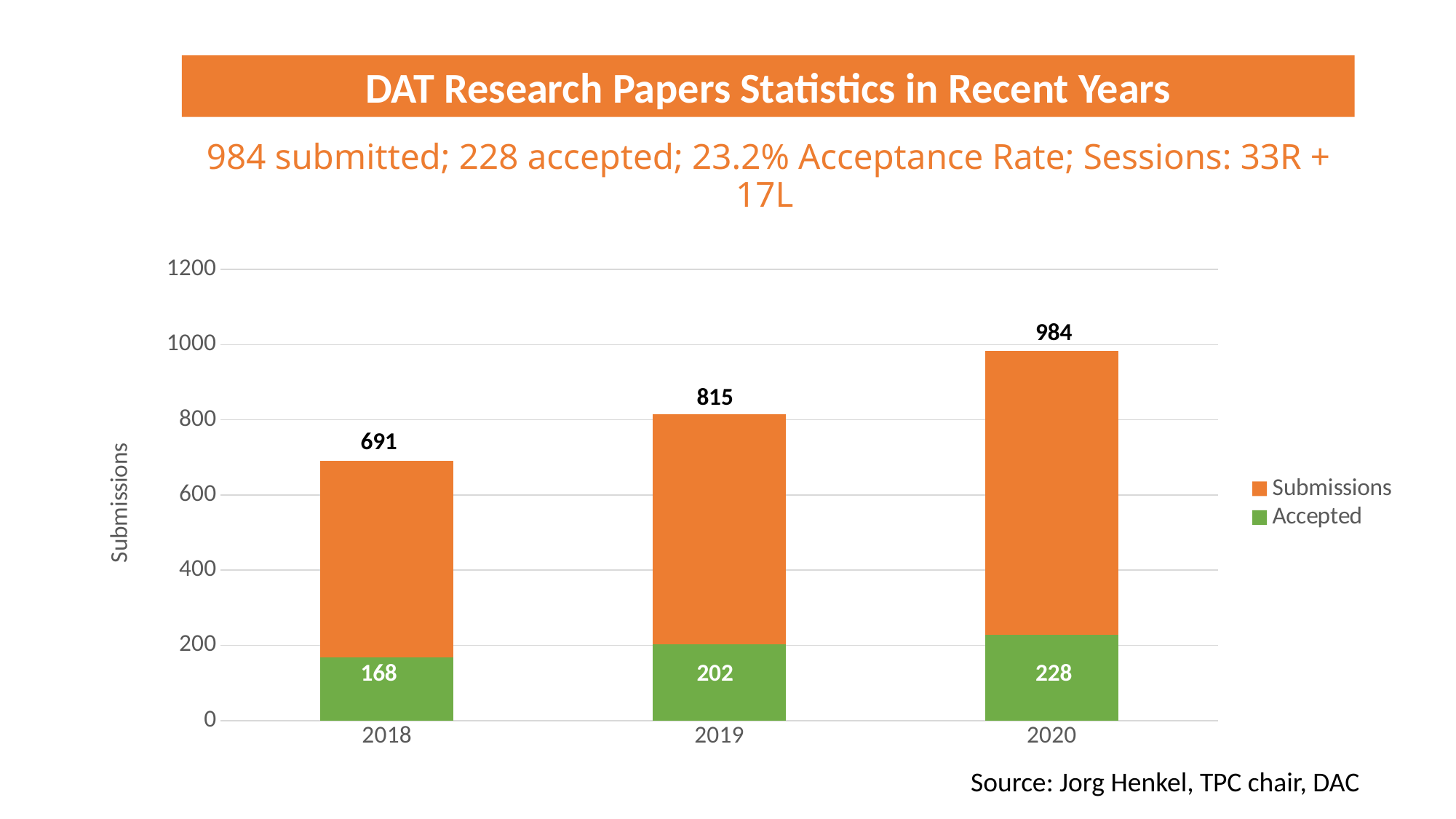
Which is larger: submissions in 2019 or submissions in 2018? 2019 How many years are shown on the x axis? 3 What is the number of submissions in 2020? 984 How many papers were accepted in 2018? 168 What is the difference between submissions in 2020 and submissions in 2018? 293 Which year has the highest number of submissions? 2020 How many more papers were accepted in 2020 than in 2019? 26 Do submissions rise or fall from 2018 to 2020? rise What is the number of submissions in 2019? 815 How many papers were accepted in 2019? 202 How many series does the legend list? 2 Which year has the lowest number of accepted papers? 2018